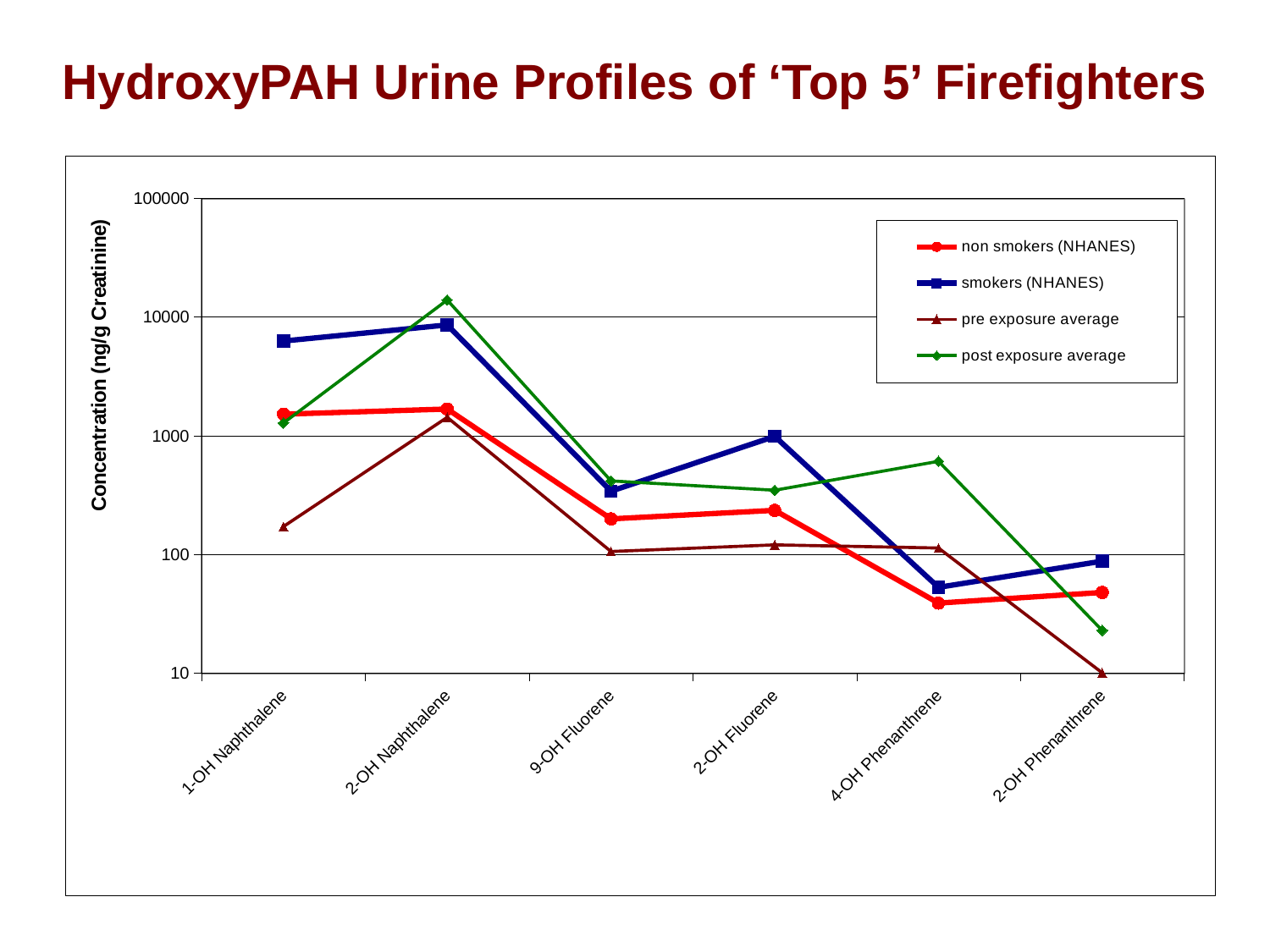
How many compound categories are plotted along the x axis? 6 Is the non smokers (NHANES) value for 4-OH Phenanthrene greater or less than 100? less What is the label on the y axis? Concentration (ng/g Creatinine) What kind of chart is shown on the slide? line chart How many series does the legend list? 4 Which series has the lowest value for 1-OH Naphthalene? pre exposure average Is the smokers (NHANES) value for 1-OH Naphthalene greater or less than 10000? less For which compound is the post exposure average highest? 2-OH Naphthalene What is the title of the chart? HydroxyPAH Urine Profiles of 'Top 5' Firefighters Is the pre exposure average for 1-OH Naphthalene greater or less than 100? greater At 4-OH Phenanthrene, which is larger: the post exposure average or the smokers (NHANES) value? post exposure average